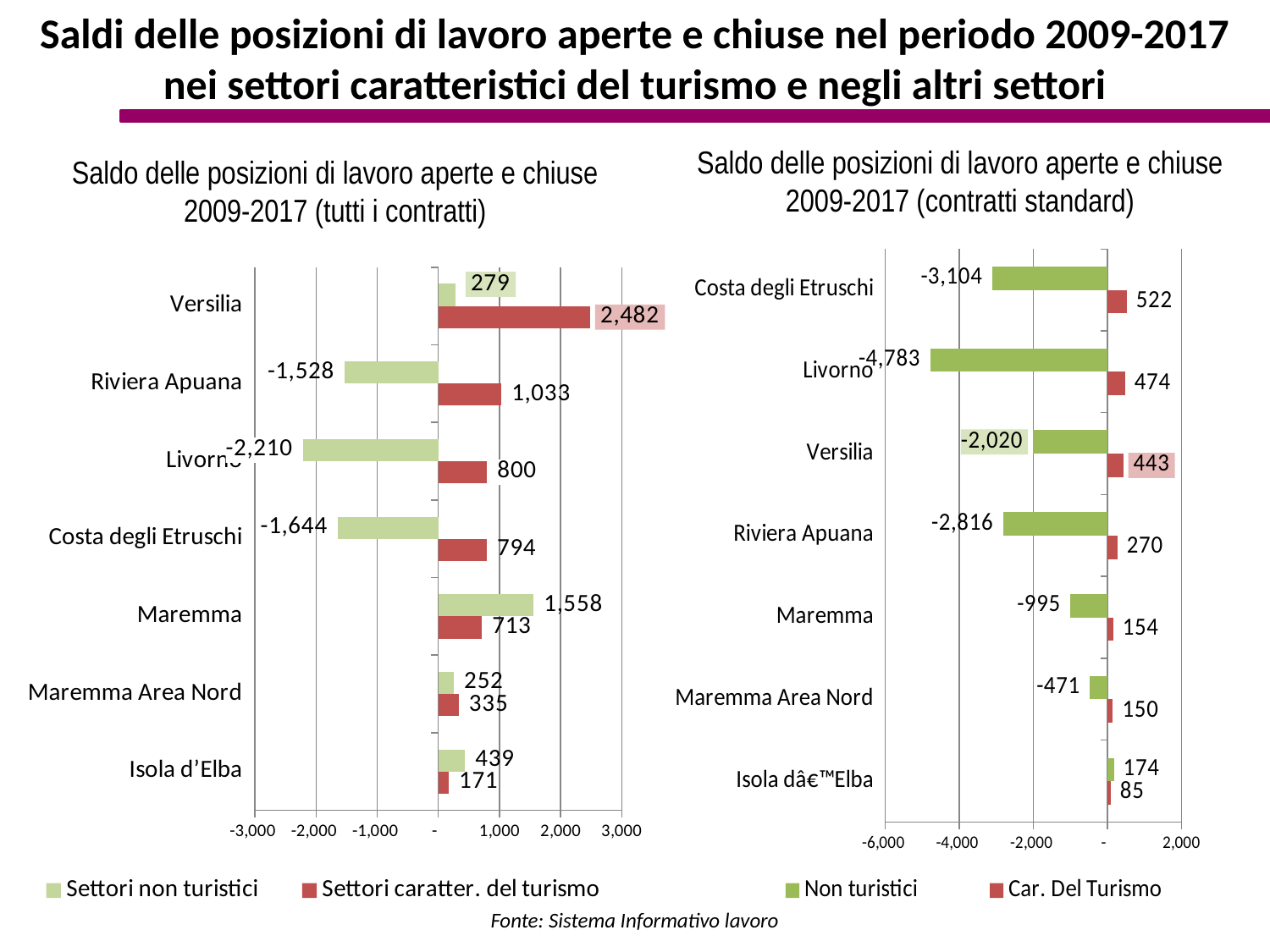
What kind of chart is the left chart (tutti i contratti)? bar chart In the left chart (tutti i contratti), how many areas are shown on the vertical axis? 7 In the right chart (contratti standard), how many series does the legend list? 2 In the left chart (tutti i contratti), what is the value for Settori caratter. del turismo in Versilia? 2,482 In the right chart (contratti standard), what is the value for Car. Del Turismo in Riviera Apuana? 270 In the left chart (tutti i contratti), what is the difference between the Settori non turistici and Settori caratter. del turismo values for Maremma? 845 In the right chart (contratti standard), is the Car. Del Turismo value for Costa degli Etruschi larger or smaller than the Car. Del Turismo value for Versilia? larger In the left chart (tutti i contratti), what is the value for Settori non turistici in Livorno? -2,210 In the right chart (contratti standard), what is the value for Non turistici in Livorno? -4,783 In the left chart (tutti i contratti), which area has the lowest value for Settori non turistici? Livorno In the right chart (contratti standard), which area has the highest value for Car. Del Turismo? Costa degli Etruschi In the left chart (tutti i contratti), which area has the highest value for Settori caratter. del turismo? Versilia